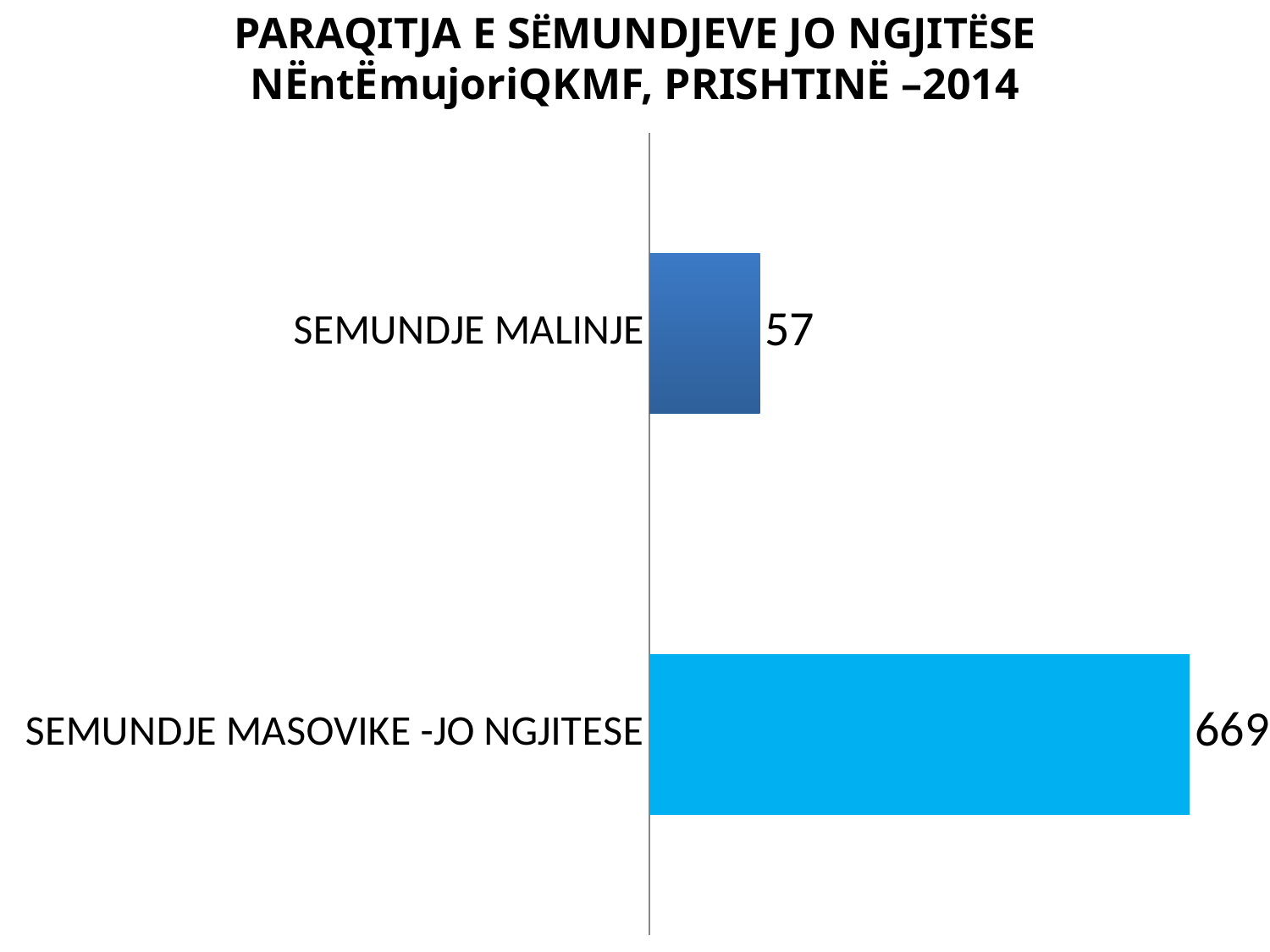
What is the difference between the values for SEMUNDJE MASOVIKE -JO NGJITESE and SEMUNDJE MALINJE? 612 What kind of chart is shown on the slide? Bar chart What is the value for SEMUNDJE MASOVIKE -JO NGJITESE? 669 Which is larger, the value for SEMUNDJE MALINJE or the value for SEMUNDJE MASOVIKE -JO NGJITESE? SEMUNDJE MASOVIKE -JO NGJITESE Which category has the lowest value? SEMUNDJE MALINJE Which category has the highest value? SEMUNDJE MASOVIKE -JO NGJITESE How many categories are shown in the chart? 2 What year is mentioned in the chart title? 2014 What colour is the bar for SEMUNDJE MASOVIKE -JO NGJITESE? Light blue What is the value for SEMUNDJE MALINJE? 57 What is the total of the two values shown in the chart? 726